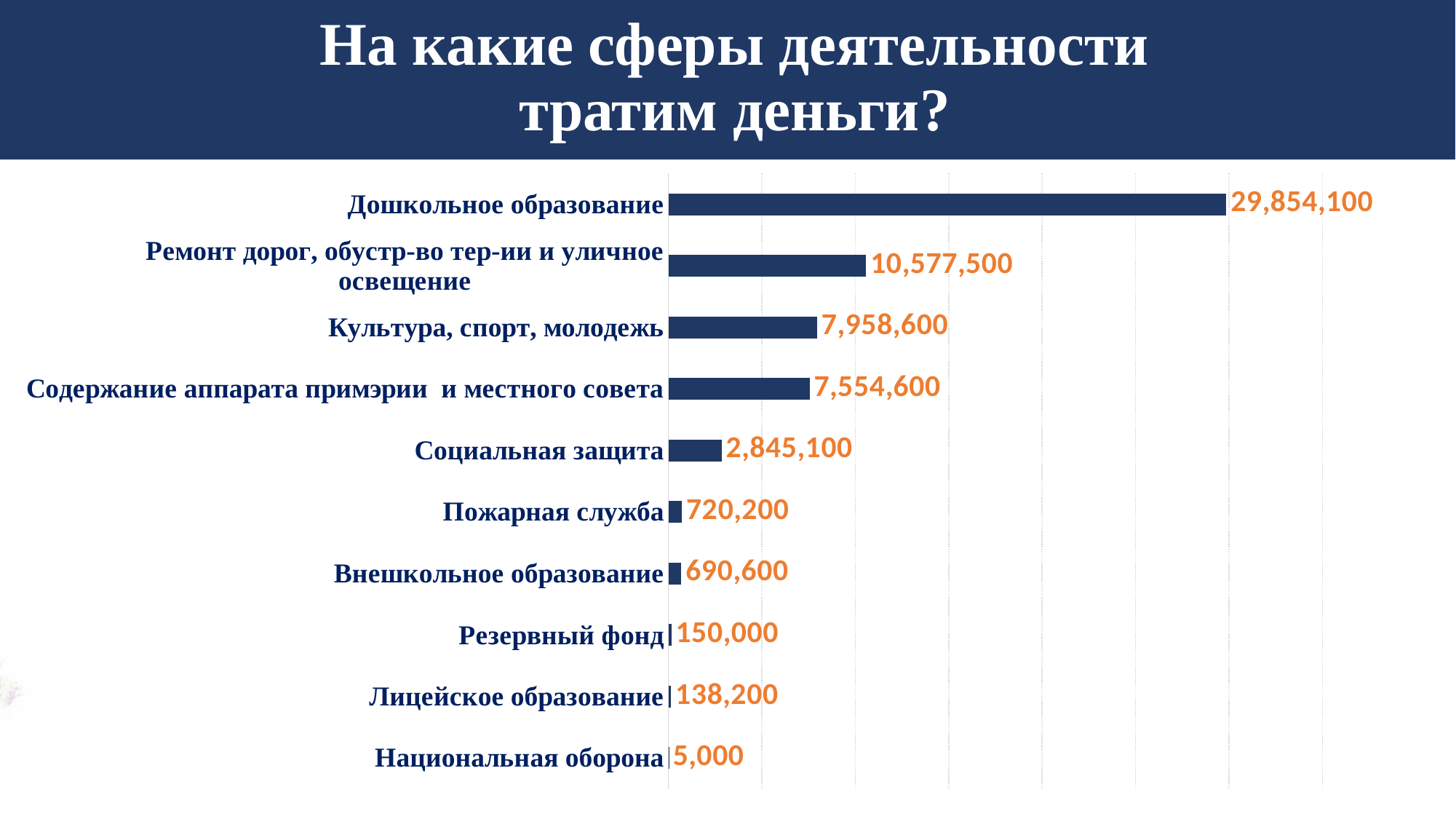
Which category has the highest value? Дошкольное образование How many categories are shown in the chart? 10 What is the difference between Дошкольное образование and Ремонт дорог, обустр-во тер-ии и уличное освещение? 19,276,600 What is the value for Национальная оборона? 5,000 Which is larger: Пожарная служба or Внешкольное образование? Пожарная служба What is the difference between Культура, спорт, молодежь and Содержание аппарата примэрии и местного совета? 404,000 Which is larger: Резервный фонд or Лицейское образование? Резервный фонд What is the value for Дошкольное образование? 29,854,100 What kind of chart is shown on the slide? Bar chart What is the value for Социальная защита? 2,845,100 Which category has the lowest value? Национальная оборона What is the value for Пожарная служба? 720,200